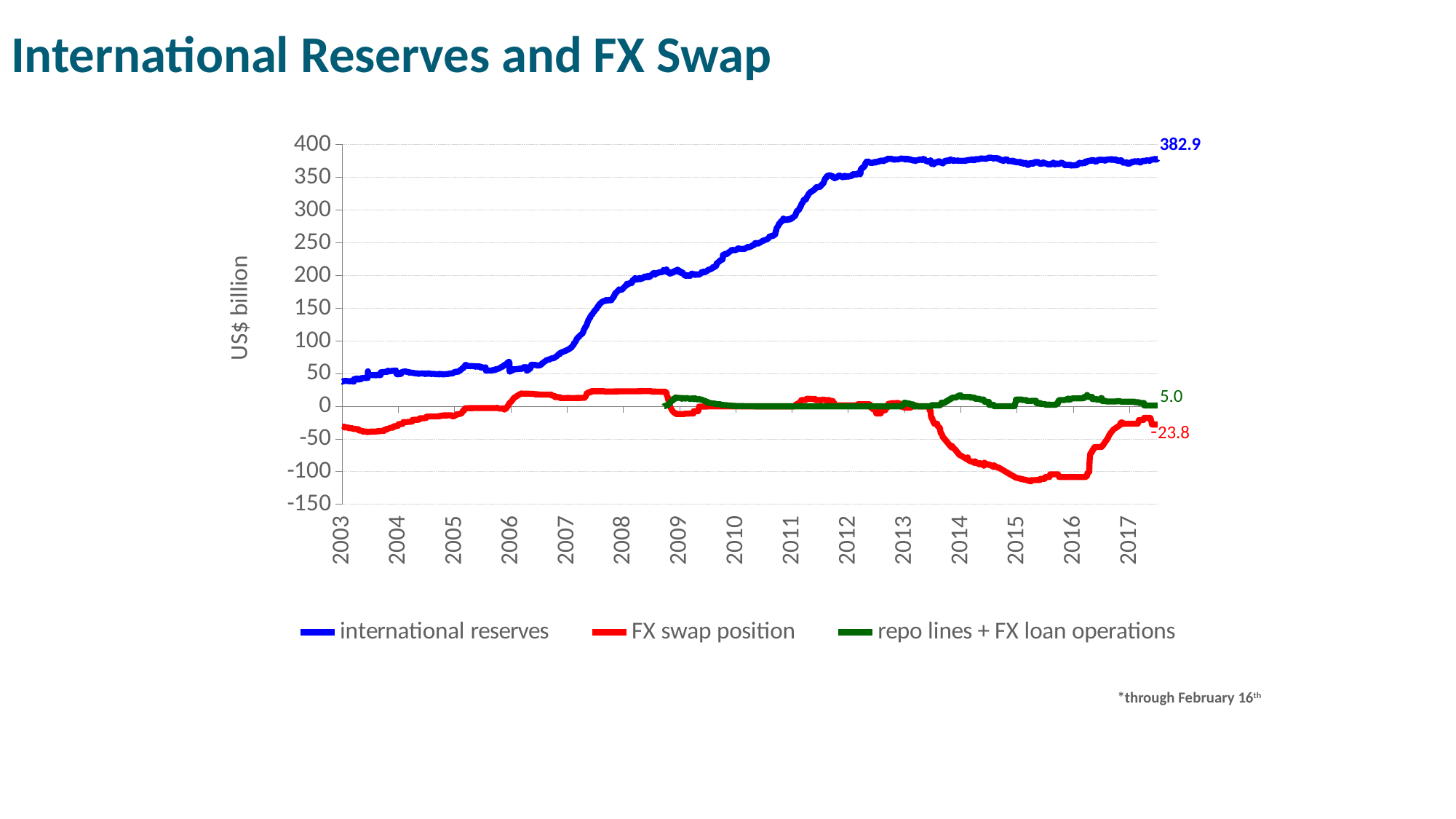
Which series has the lowest value at the end of the chart? FX swap position What is the label on the vertical axis? US$ billion What is the latest value shown for international reserves? 382.9 Do international reserves generally rise or fall from 2003 to 2013? rise Which series has the highest value at the end of the chart? international reserves What is the latest value shown for repo lines + FX loan operations? 5.0 Is the value of international reserves in 2003 greater or less than 100? less Is the FX swap position in 2015 greater or less than -50? less What is the difference between the final international reserves value and the final repo lines + FX loan operations value? 377.9 What is the latest value shown for the FX swap position? -23.8 How many series does the legend list? 3 What kind of chart is shown on the slide? line chart